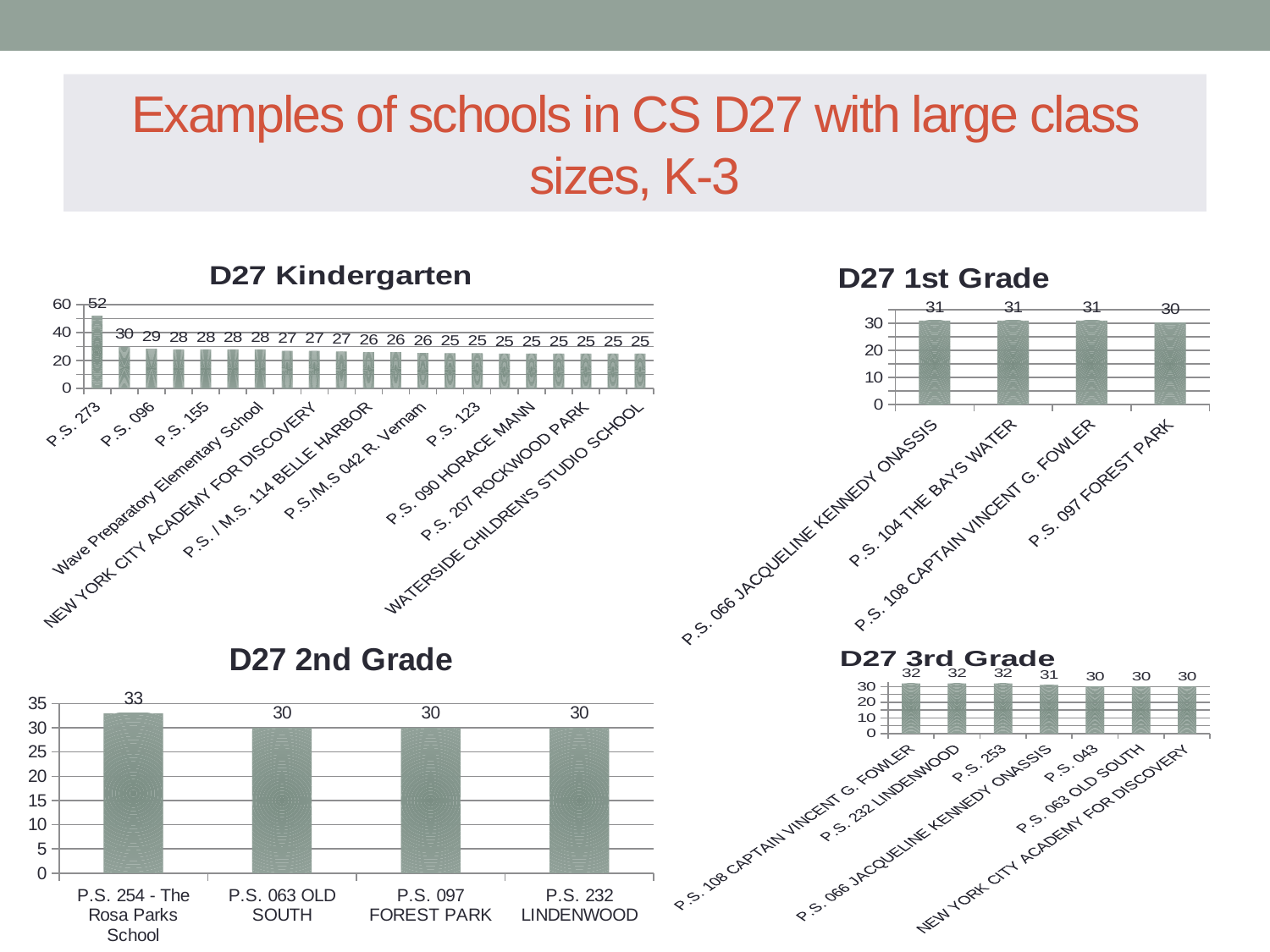
In the D27 3rd Grade chart, what is the value for P.S. 066 JACQUELINE KENNEDY ONASSIS? 31 In the D27 1st Grade chart, which school has the lowest value? P.S. 097 FOREST PARK How many bars are plotted in the D27 Kindergarten chart? 21 In the D27 3rd Grade chart, which is larger: the value for P.S. 253 or the value for P.S. 043? P.S. 253 In the D27 Kindergarten chart, which school has the highest value? P.S. 273 How many schools are shown in the D27 3rd Grade chart? 7 In the D27 2nd Grade chart, what is the value for P.S. 254 - The Rosa Parks School? 33 In the D27 1st Grade chart, what is the value for P.S. 097 FOREST PARK? 30 How many schools are shown in the D27 1st Grade chart? 4 In the D27 Kindergarten chart, what is the value for P.S. 273? 52 In the D27 2nd Grade chart, what is the difference between P.S. 254 - The Rosa Parks School and P.S. 063 OLD SOUTH? 3 What type of chart is the D27 2nd Grade chart? Bar chart